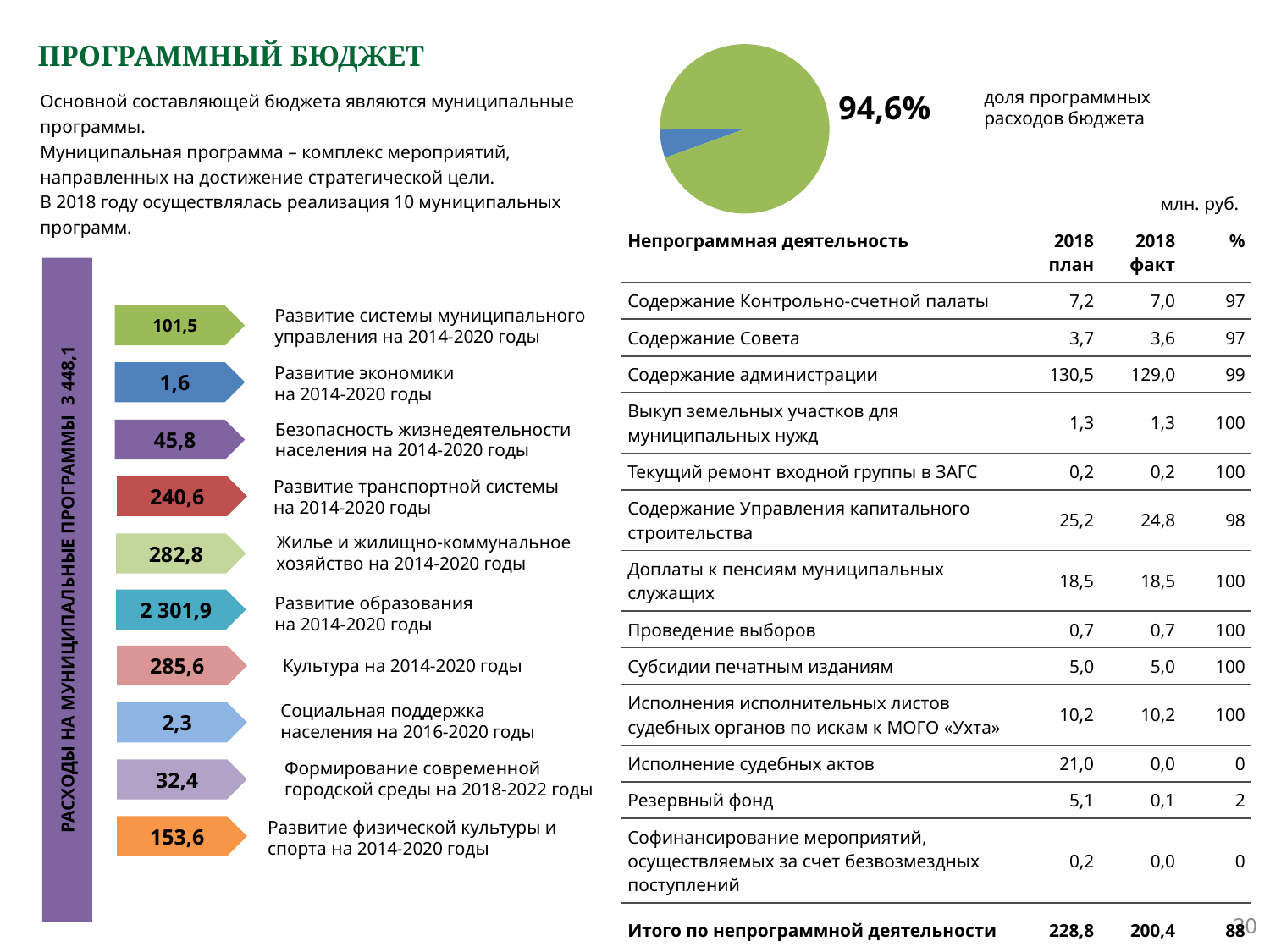
What total for expenditure on municipal programmes is printed on the vertical bar on the left of the slide? 3 448,1 How many slices does the pie chart at the top right have? 2 In the list of municipal programmes on the left, which programme has the highest value? Развитие образования на 2014-2020 годы In the list of municipal programmes on the left, what value is shown for 'Развитие образования на 2014-2020 годы'? 2 301,9 How many municipal programmes are listed in the diagram on the left? 10 According to the text next to the pie chart, what does the 94,6% represent? доля программных расходов бюджета In the diagram on the left, what is the difference between the values for 'Культура на 2014-2020 годы' and 'Жилье и жилищно-коммунальное хозяйство на 2014-2020 годы'? 2,8 In the pie chart at the top right, what share is printed next to the large slice? 94,6% In the list of municipal programmes on the left, which programme has the lowest value? Развитие экономики на 2014-2020 годы What colour is the large slice of the pie chart at the top right? green In the diagram on the left, which has the larger value: 'Развитие транспортной системы на 2014-2020 годы' or 'Развитие физической культуры и спорта на 2014-2020 годы'? Развитие транспортной системы на 2014-2020 годы What kind of chart is shown at the top right of the slide? pie chart